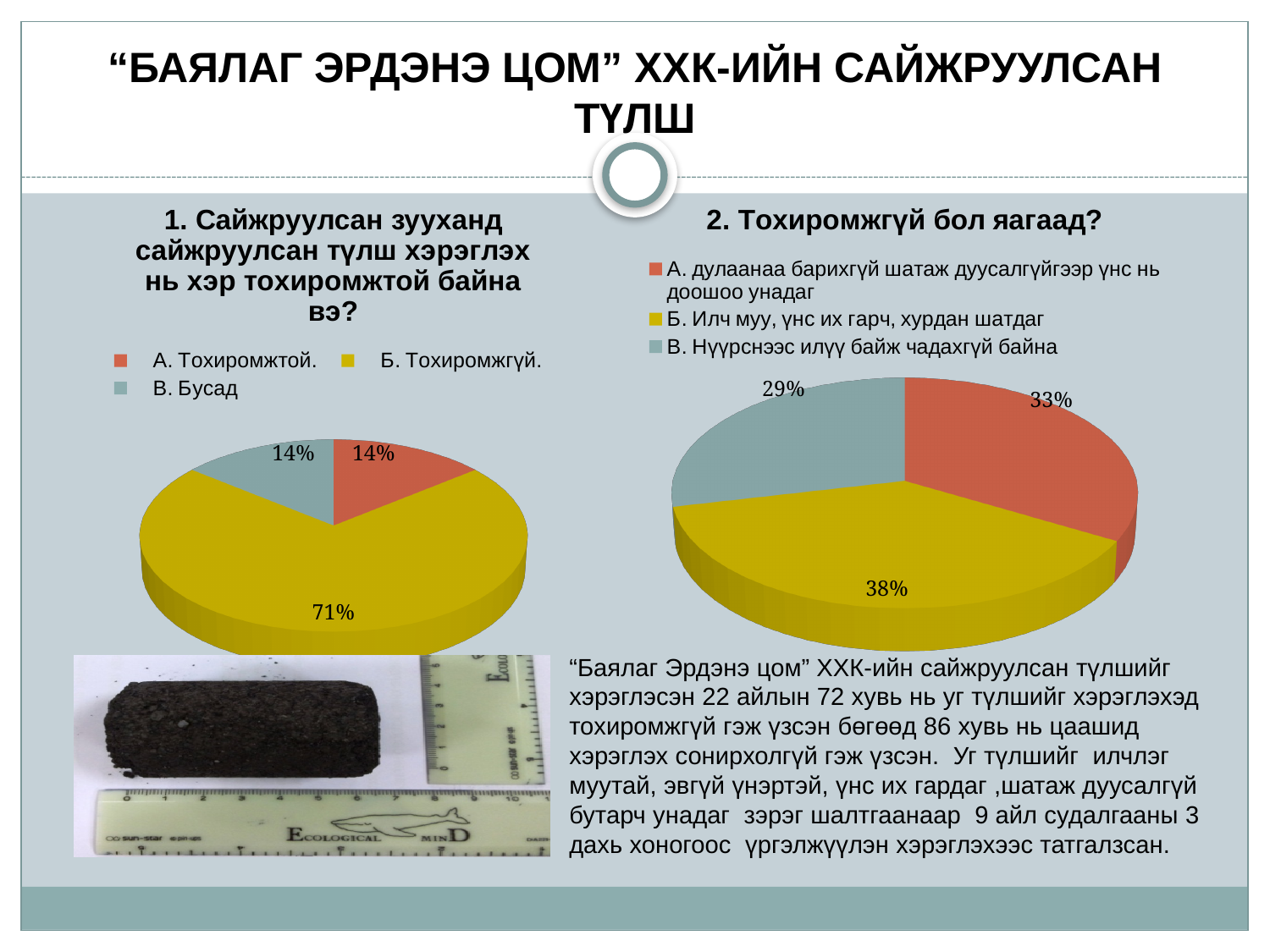
In the right pie chart (question 2), what share is labelled for В. Нүүрснээс илүү байж чадахгүй байна? 29% In the right pie chart (question 2), what share is labelled for А. дулаанаа барихгүй шатаж дуусалгүйгээр үнс нь доошоо унадаг? 33% In the right pie chart (question 2), which is larger: the share for А or the share for Б? Б In the left pie chart (question 1), what share is labelled for Б. Тохиромжгүй? 71% In the left pie chart (question 1), which category has the largest slice? Б. Тохиромжгүй In the right pie chart (question 2), what colour is the slice for Б. Илч муу, үнс их гарч, хурдан шатдаг? Yellow What type of chart is used on the right side of the slide (question 2)? Pie chart In the right pie chart (question 2), which category has the smallest slice? В. Нүүрснээс илүү байж чадахгүй байна In the left pie chart (question 1), how many categories does the legend list? 3 In the right pie chart (question 2), what share is labelled for Б. Илч муу, үнс их гарч, хурдан шатдаг? 38% In the left pie chart (question 1), what is the difference between the shares for Б. Тохиромжгүй and В. Бусад? 57 percentage points In the left pie chart (question 1), what share is labelled for А. Тохиромжтой? 14%